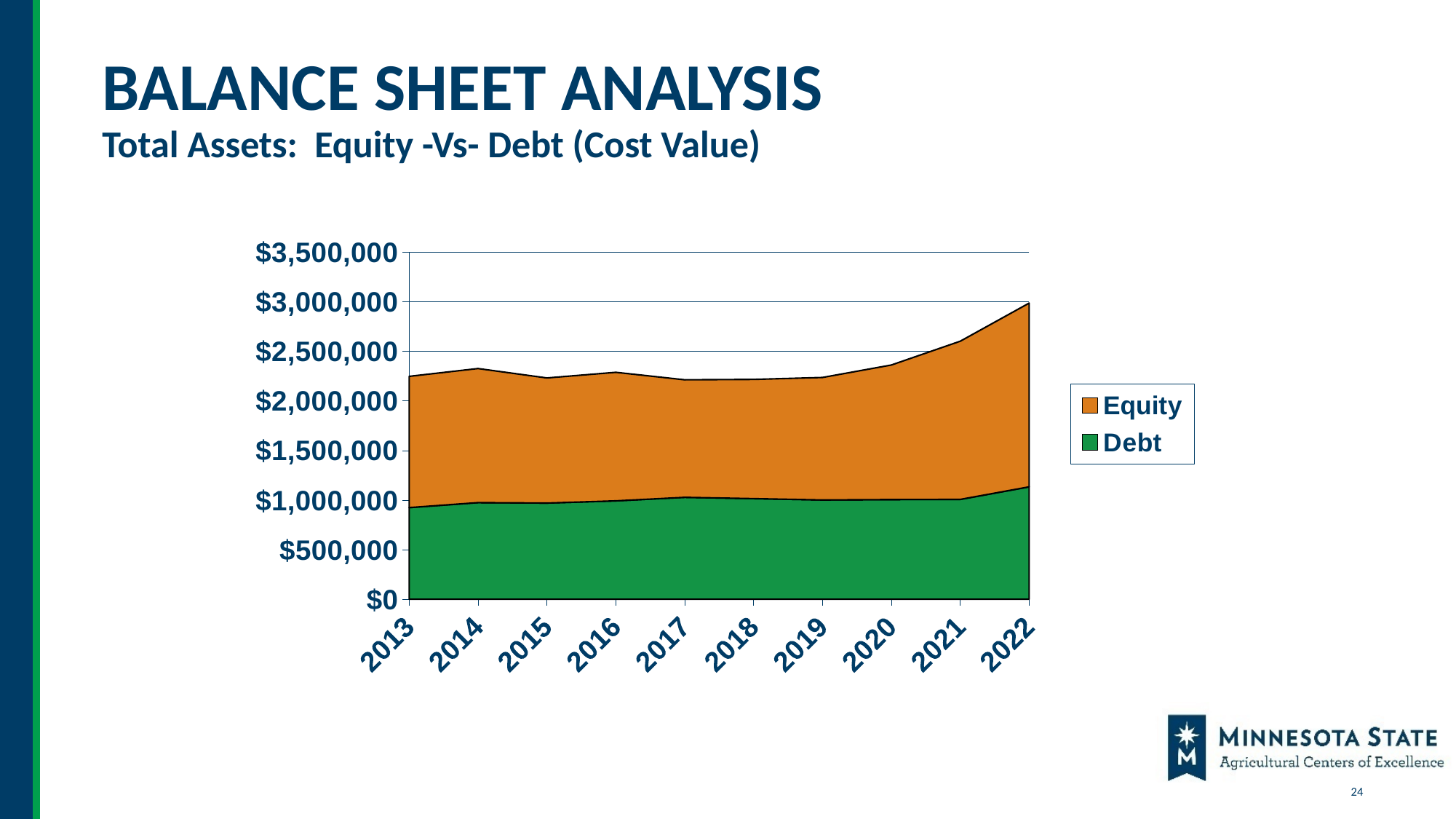
Is the Debt value in 2022 greater or less than $1,000,000? greater Is the total of Equity and Debt in 2013 greater or less than $2,000,000? greater Which series is shown in orange? Equity Do total assets rise or fall from 2019 to 2022? rise Is the total of Equity and Debt in 2019 greater or less than $2,500,000? less What kind of chart is shown on the slide? Stacked area chart In which year are total assets (Equity plus Debt) highest? 2022 What is the subtitle of the chart on the slide? Total Assets: Equity -Vs- Debt (Cost Value) How many years are plotted along the x axis? 10 How many series does the legend list? 2 Are total assets larger in 2022 or in 2013? 2022